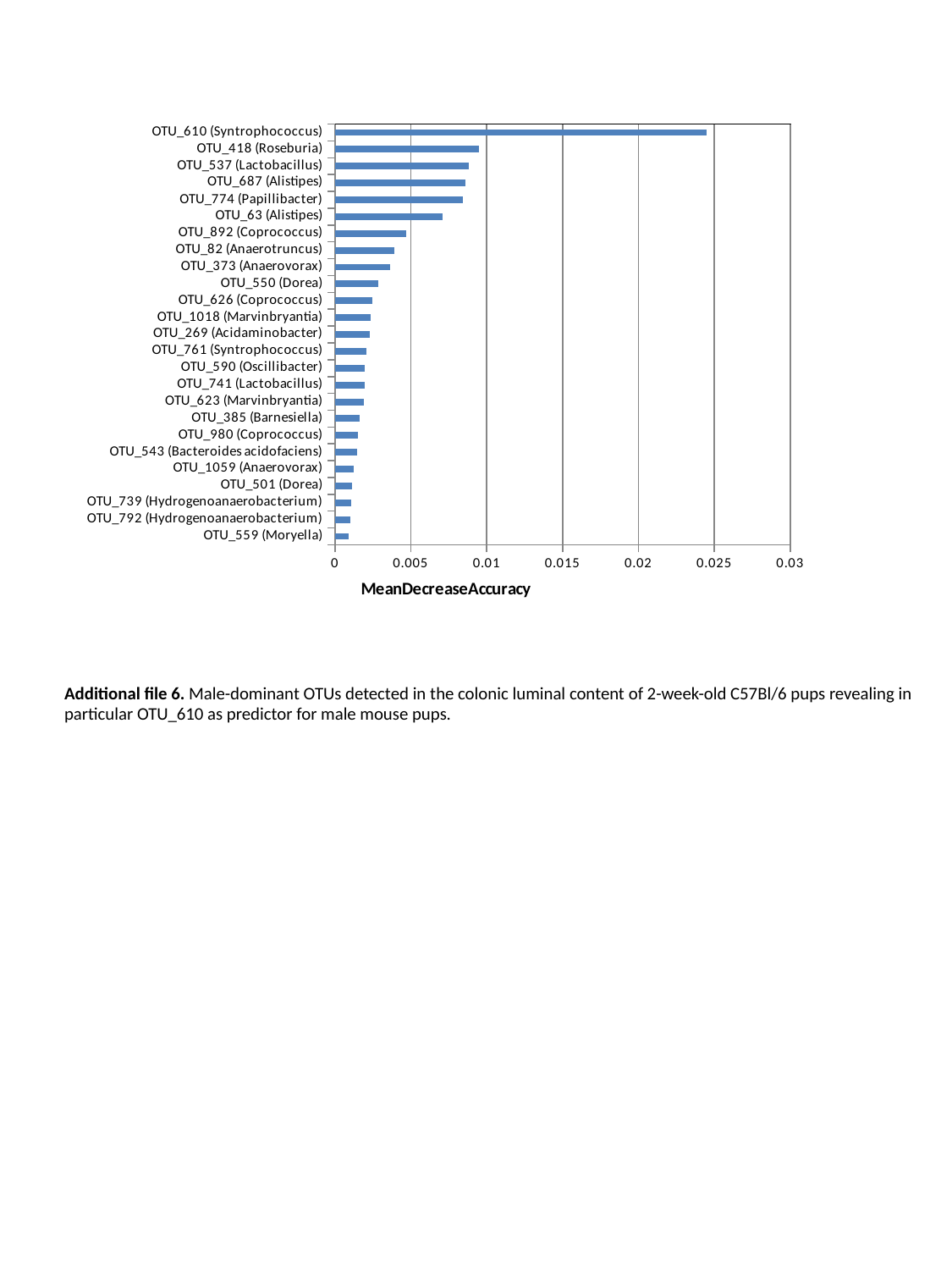
Which has a larger MeanDecreaseAccuracy, OTU_63 (Alistipes) or OTU_892 (Coprococcus)? OTU_63 (Alistipes) Is the value for OTU_418 (Roseburia) greater or less than 0.005? greater Is the value for OTU_610 (Syntrophococcus) greater or less than 0.02? greater Which OTU has the highest MeanDecreaseAccuracy? OTU_610 (Syntrophococcus) Is the value for OTU_63 (Alistipes) greater or less than 0.01? less What kind of chart is shown on the slide? bar chart Which has a larger MeanDecreaseAccuracy, OTU_82 (Anaerotruncus) or OTU_1018 (Marvinbryantia)? OTU_82 (Anaerotruncus) Do the bar lengths increase or decrease going from the top of the chart to the bottom? decrease What is the title of the horizontal axis? MeanDecreaseAccuracy How many OTUs are plotted in the chart? 25 Which has a larger MeanDecreaseAccuracy, OTU_610 (Syntrophococcus) or OTU_418 (Roseburia)? OTU_610 (Syntrophococcus)